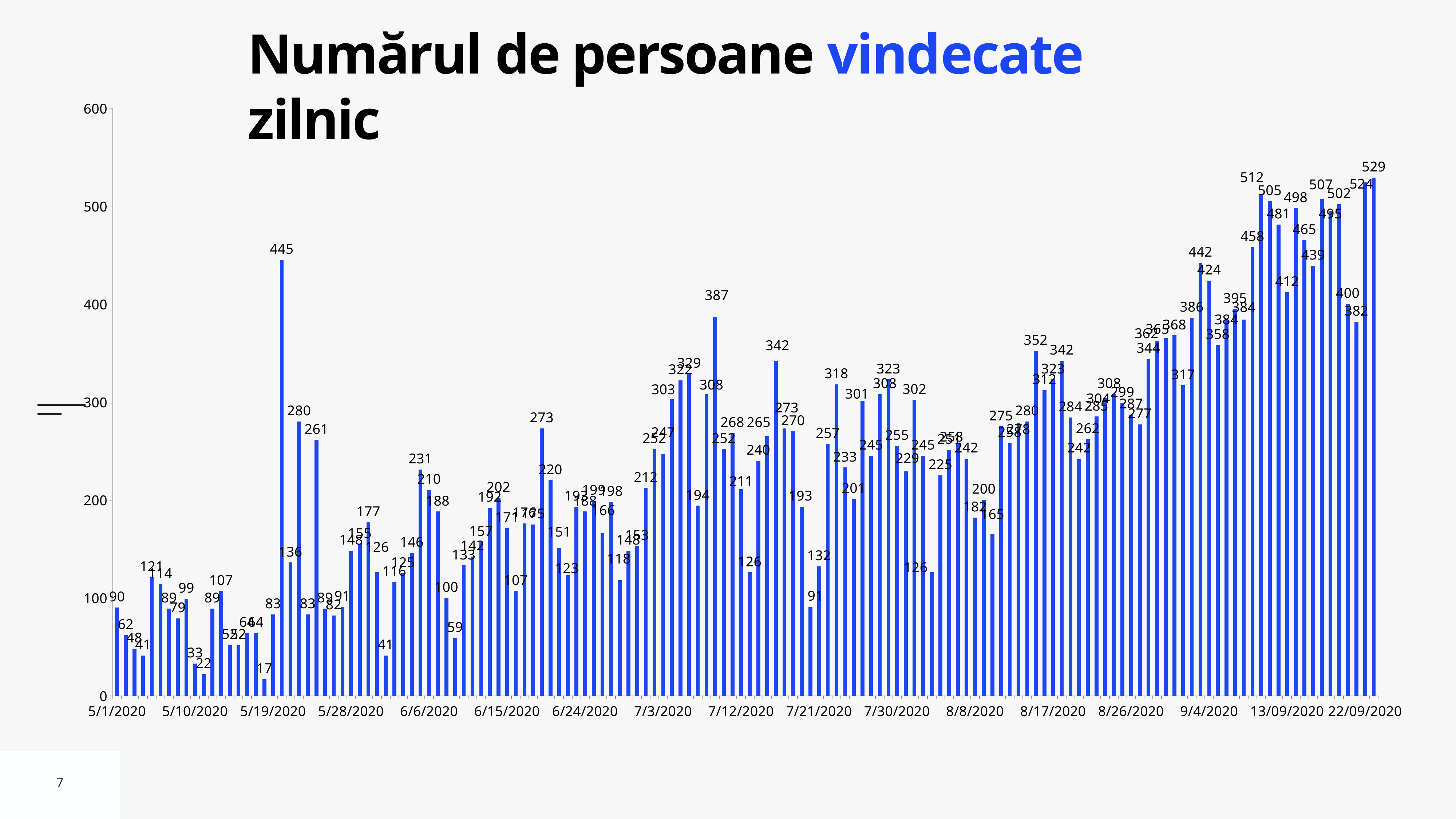
What is the value for 5/1/2020, the first bar on the chart? 90 Is the value for 5/1/2020 greater or less than 100? less What is the title of the chart? Numărul de persoane vindecate zilnic Do the values generally rise or fall from May to September along the x axis? rise What is the highest value shown on the chart? 529 What is the maximum value shown on the vertical axis? 600 Which is larger, the peak of 445 in May or the peak of 387 in July? 445 What kind of chart is shown on the slide? bar chart What is the lowest value shown on the chart? 17